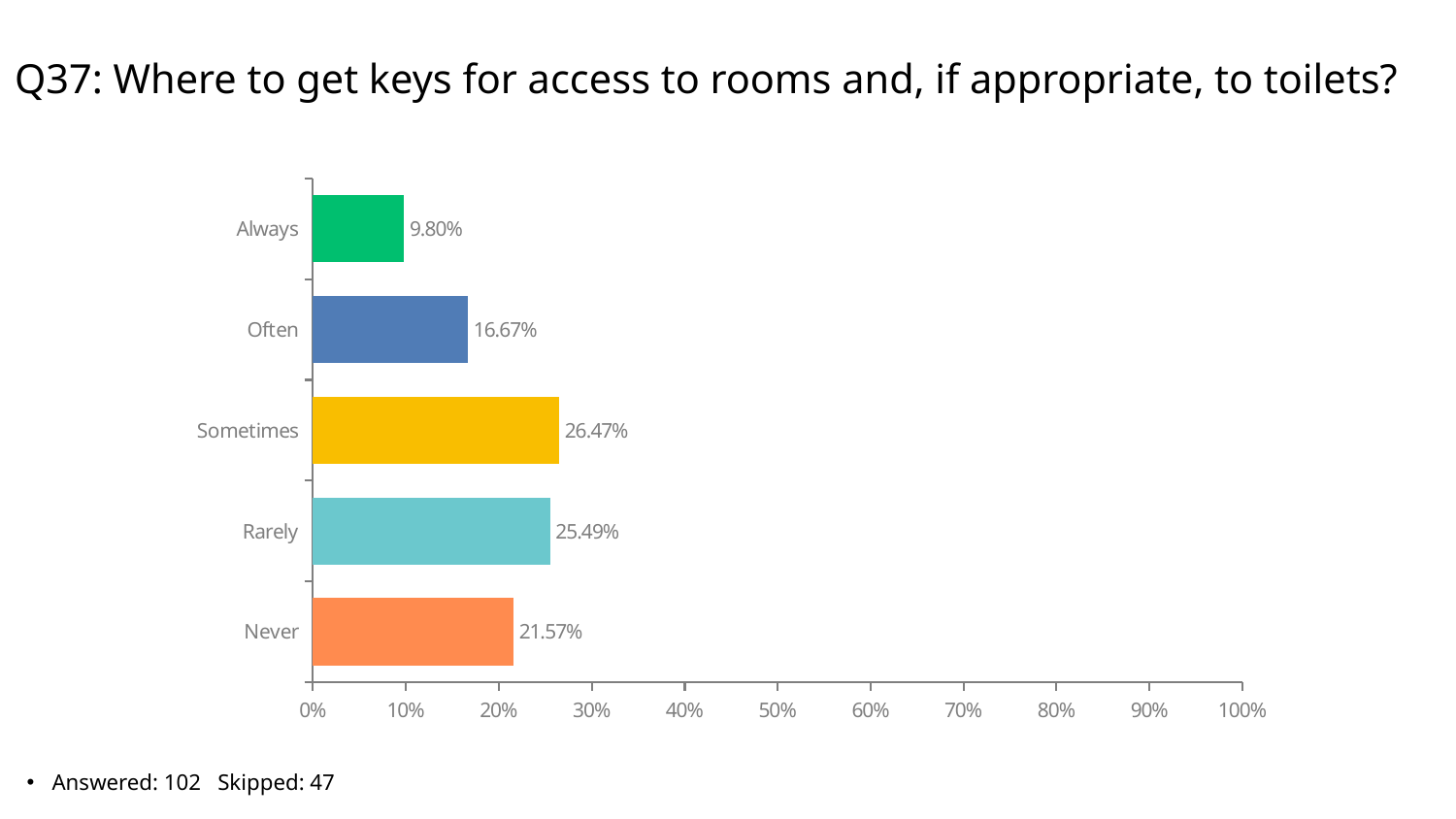
How many categories are shown in the chart? 5 What is the maximum value shown on the x axis? 100% What percentage is shown for "Never"? 21.57% Which category has the lowest value? Always What colour is the bar for "Sometimes"? yellow Which category has the highest value? Sometimes What is the value shown for "Sometimes"? 26.47% What percentage of respondents answered "Always"? 9.80% What is the difference between the values for "Often" and "Always"? 6.87% What kind of chart is shown on the slide? bar chart Is the value for "Often" greater or less than 20%? less Which is larger, the value for "Rarely" or the value for "Never"? Rarely